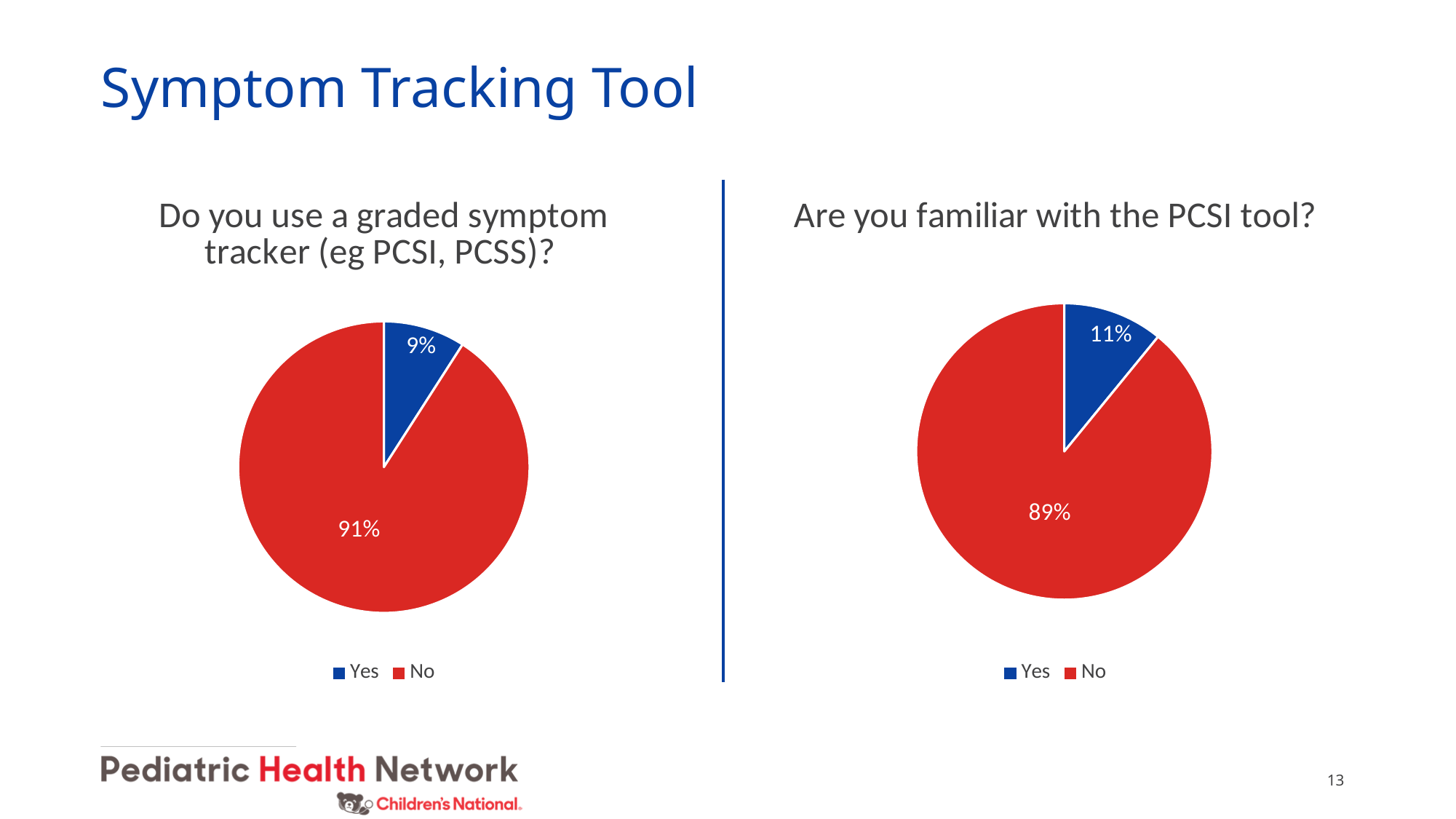
In the right chart 'Are you familiar with the PCSI tool?', what share of respondents answered No? 89% In the left chart 'Do you use a graded symptom tracker (eg PCSI, PCSS)?', what share of respondents answered Yes? 9% In the left chart 'Do you use a graded symptom tracker (eg PCSI, PCSS)?', what is the difference between the No and Yes shares? 82% In the right chart 'Are you familiar with the PCSI tool?', which response has the smallest slice? Yes Which chart has the larger Yes share, the left chart 'Do you use a graded symptom tracker (eg PCSI, PCSS)?' or the right chart 'Are you familiar with the PCSI tool?'? Are you familiar with the PCSI tool? In the left chart 'Do you use a graded symptom tracker (eg PCSI, PCSS)?', what colour is the Yes slice? Blue How many categories does the legend of the right chart 'Are you familiar with the PCSI tool?' list? 2 What kind of chart is used on the left for 'Do you use a graded symptom tracker (eg PCSI, PCSS)?'? Pie chart In the right chart 'Are you familiar with the PCSI tool?', what share of respondents answered Yes? 11% In the left chart 'Do you use a graded symptom tracker (eg PCSI, PCSS)?', which response has the largest slice? No In the right chart 'Are you familiar with the PCSI tool?', what is the difference between the No and Yes shares? 78% In the left chart 'Do you use a graded symptom tracker (eg PCSI, PCSS)?', what share of respondents answered No? 91%